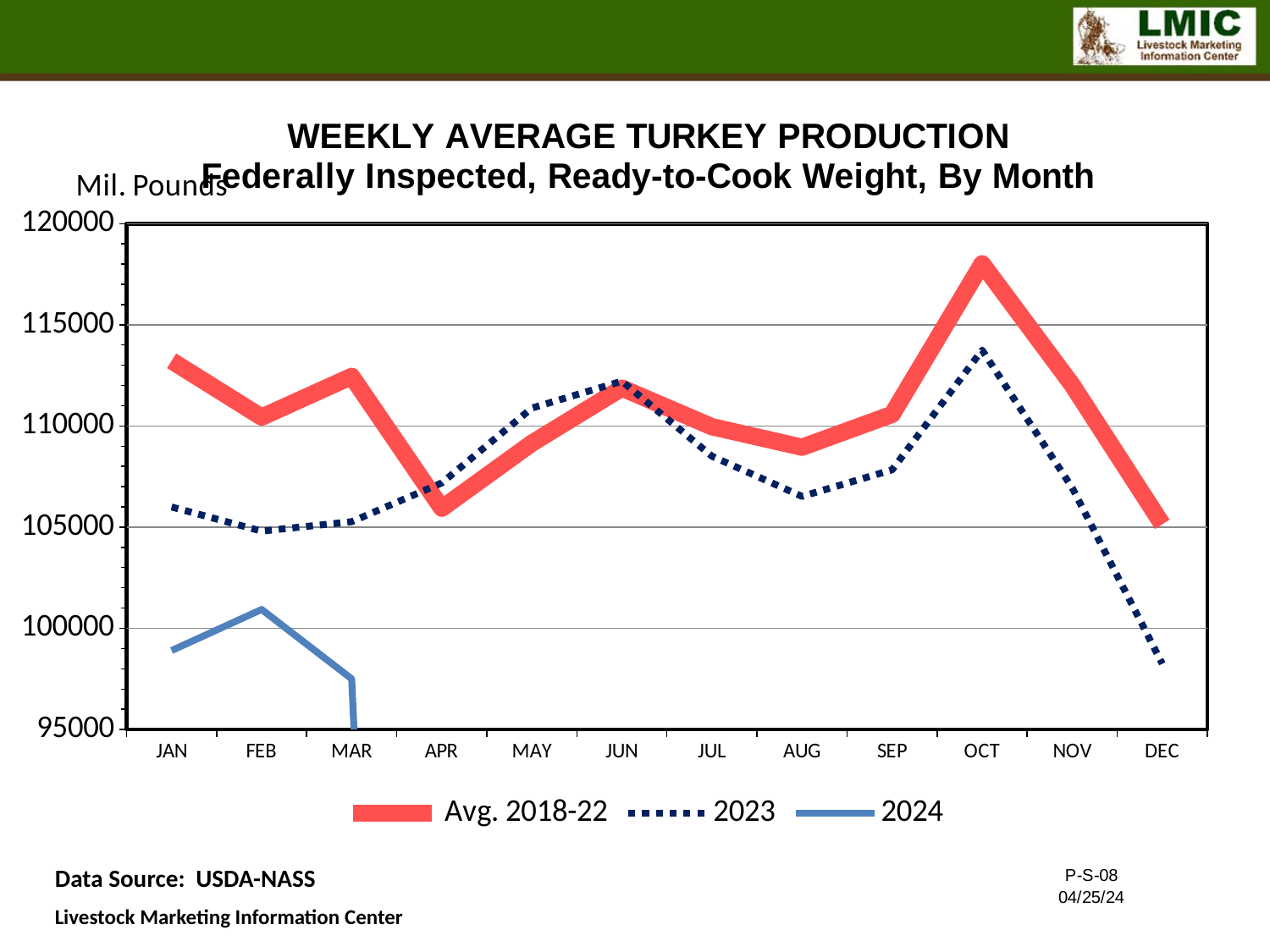
What kind of chart is shown on the slide? line chart Does the 2023 series rise or fall from OCT to DEC? fall What unit label is shown above the y axis? Mil. Pounds In which month does the 2023 series reach its lowest value? DEC In which month does the Avg. 2018-22 series reach its highest value? OCT Is the 2023 value for DEC greater or less than 100000? less Which series has the larger value in AUG, Avg. 2018-22 or 2023? Avg. 2018-22 Is the Avg. 2018-22 value for OCT greater or less than 115000? greater How many series does the legend list? 3 In which month does the 2024 series reach its highest value? FEB Is the 2024 value for JAN greater or less than 100000? less How many months are shown along the x axis? 12